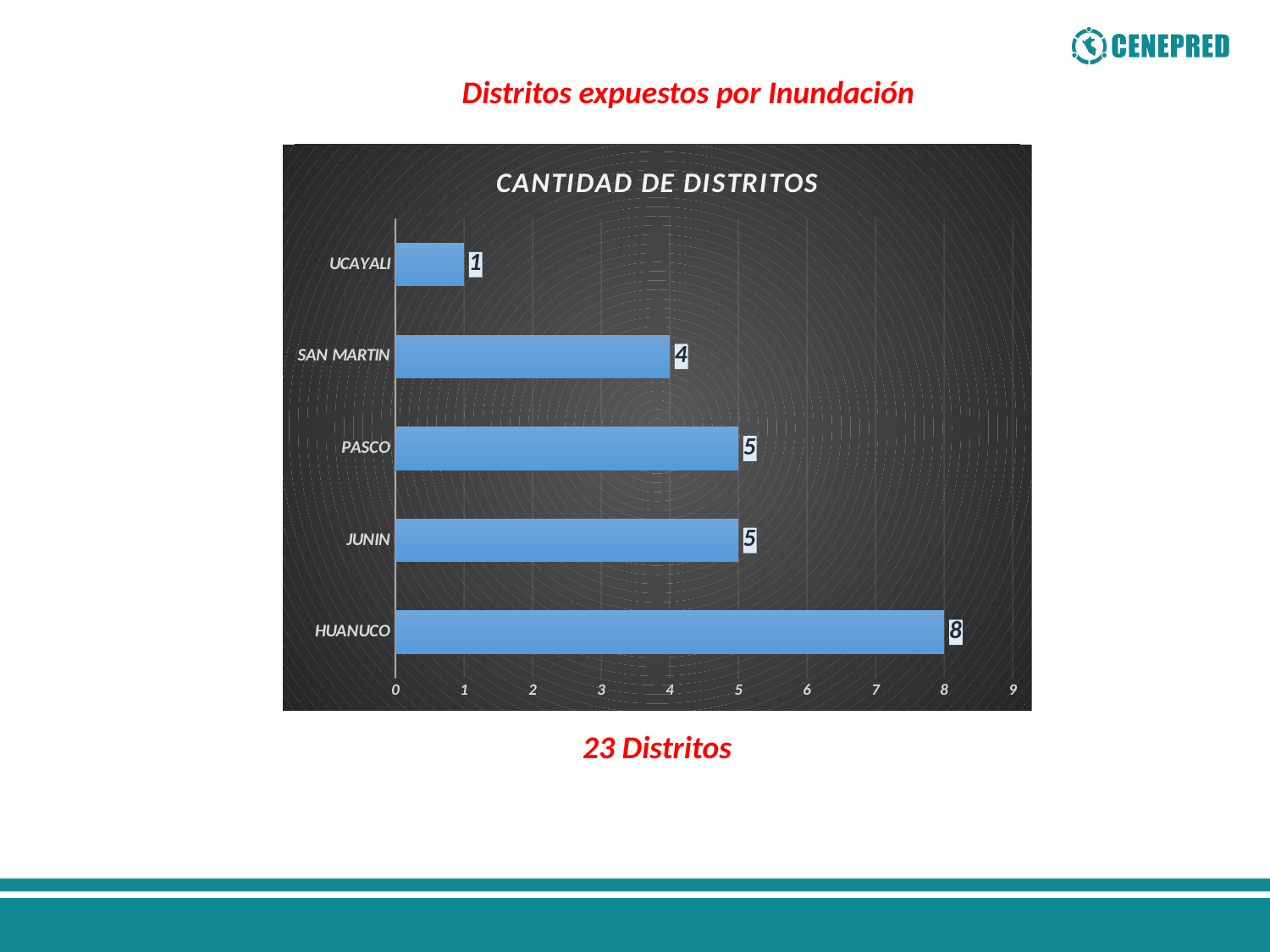
What is the value for JUNIN? 5 What is the difference between the values for HUANUCO and SAN MARTIN? 4 What is the title of the chart? CANTIDAD DE DISTRITOS Is the value for HUANUCO greater or less than 5? greater Which category has the lowest value? UCAYALI What is the value for SAN MARTIN? 4 What kind of chart is shown? bar chart Which category has the highest value? HUANUCO Which is larger, the value for PASCO or the value for UCAYALI? PASCO What is the value for HUANUCO? 8 What is the value for UCAYALI? 1 How many categories are shown in the chart? 5